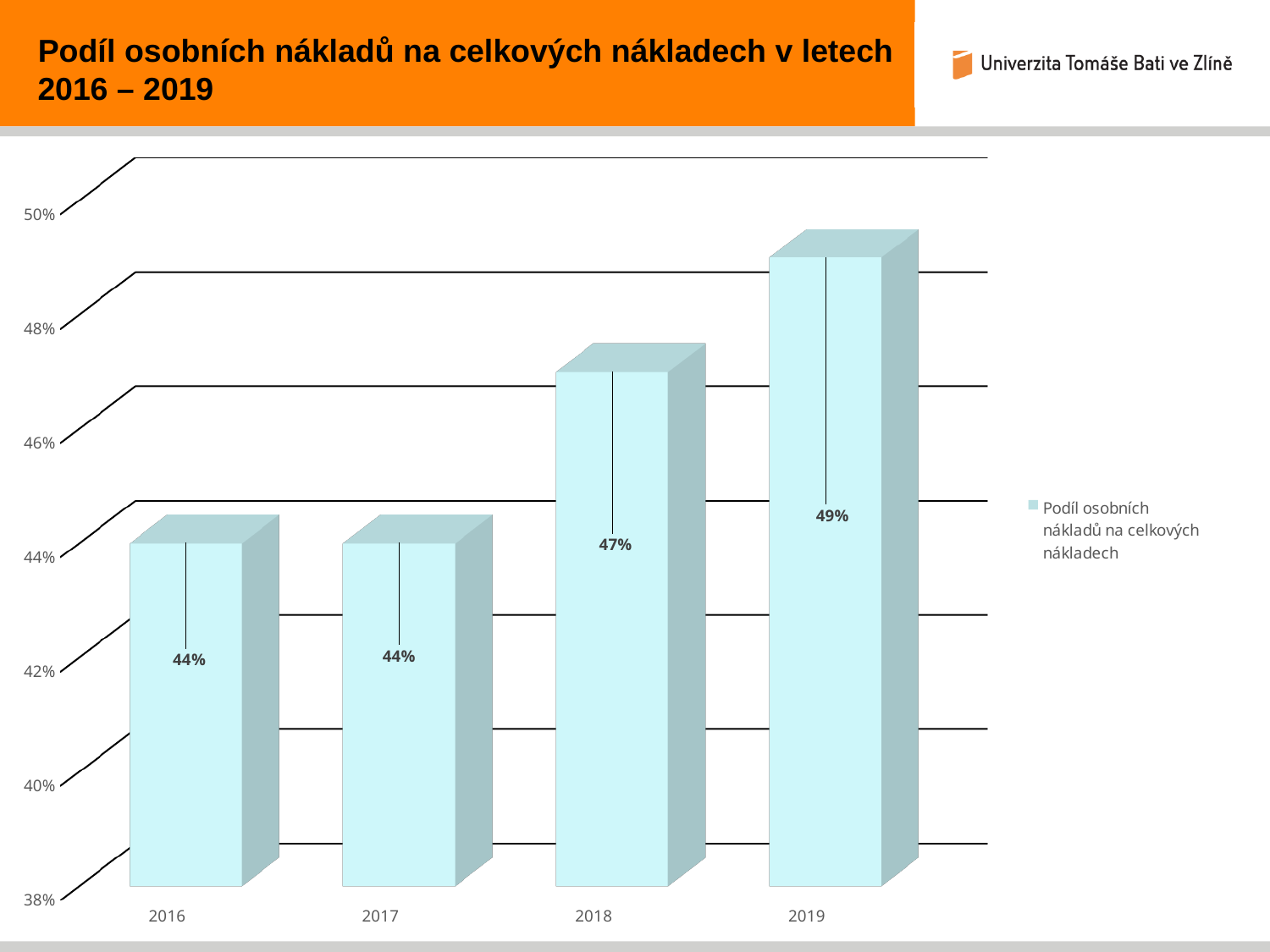
What is the difference between the values for 2019 and 2016? 5% What is the value for 2018? 47% What is the difference between the values for 2018 and 2017? 3% How many series does the legend list? 1 Do the values rise or fall from 2016 to 2019? rise What is the value for 2019? 49% Is the value for 2019 greater or less than 48%? greater How many years are shown on the x axis? 4 Which is larger, the value for 2018 or the value for 2017? 2018 What kind of chart is shown on the slide? bar chart Which year has the highest value? 2019 What is the value for 2016? 44%